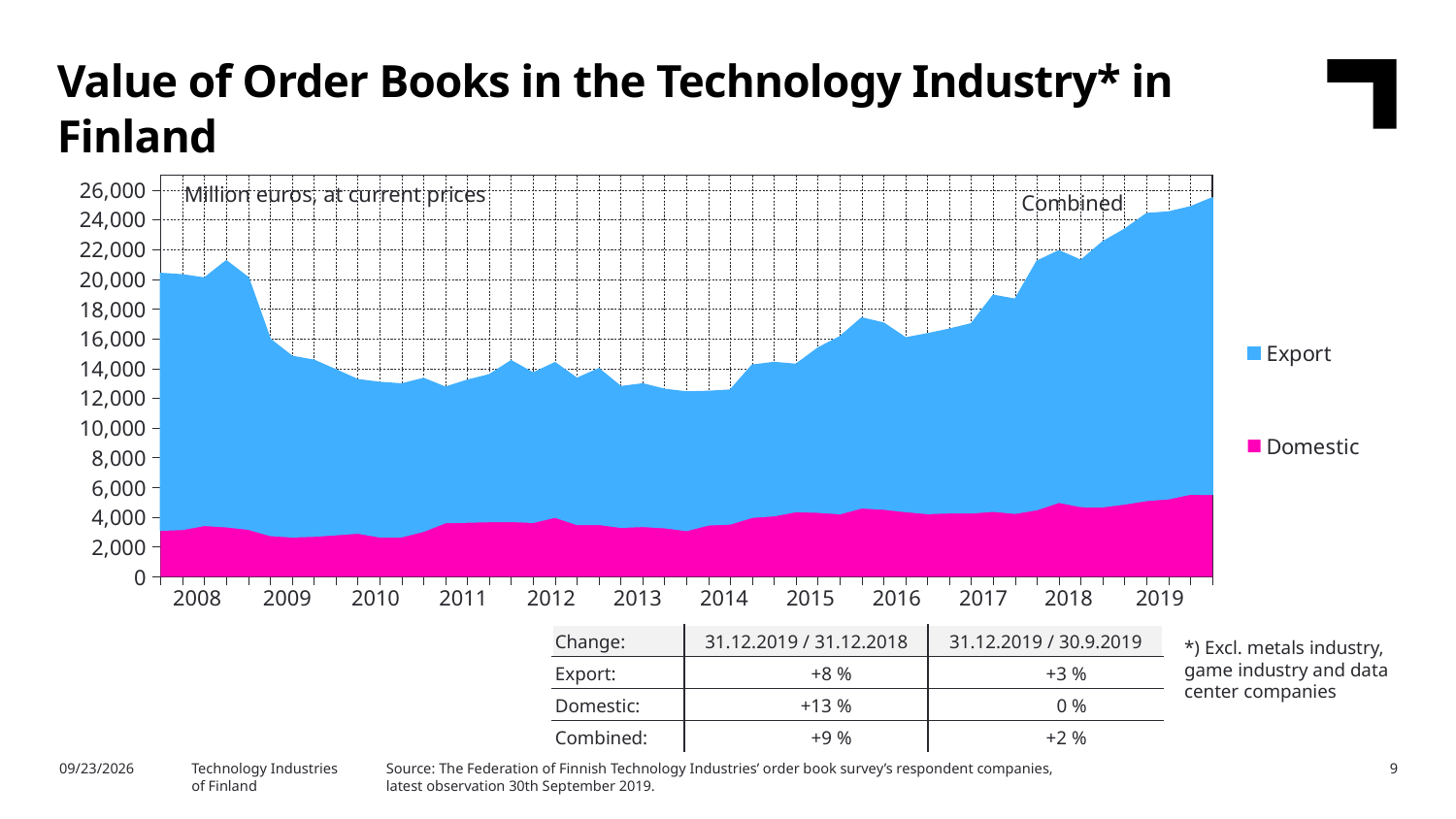
Does the combined value of order books rise or fall from 2008 to 2009? fall How many series does the chart's legend list? 2 What kind of chart is shown on the slide? Stacked area chart What unit is stated in the label at the top of the chart? Million euros, at current prices Is the combined value of order books at the end of 2019 greater or less than 24,000? greater Does the combined value of order books rise or fall from 2017 to 2019? rise Is the Domestic value in 2010 greater or less than 4,000? less Which series is larger throughout the chart, Export or Domestic? Export Is the Domestic value at the end of 2019 greater or less than 4,000? greater How many years are labelled on the x axis of the chart? 12 Which two series are listed in the chart's legend? Export and Domestic